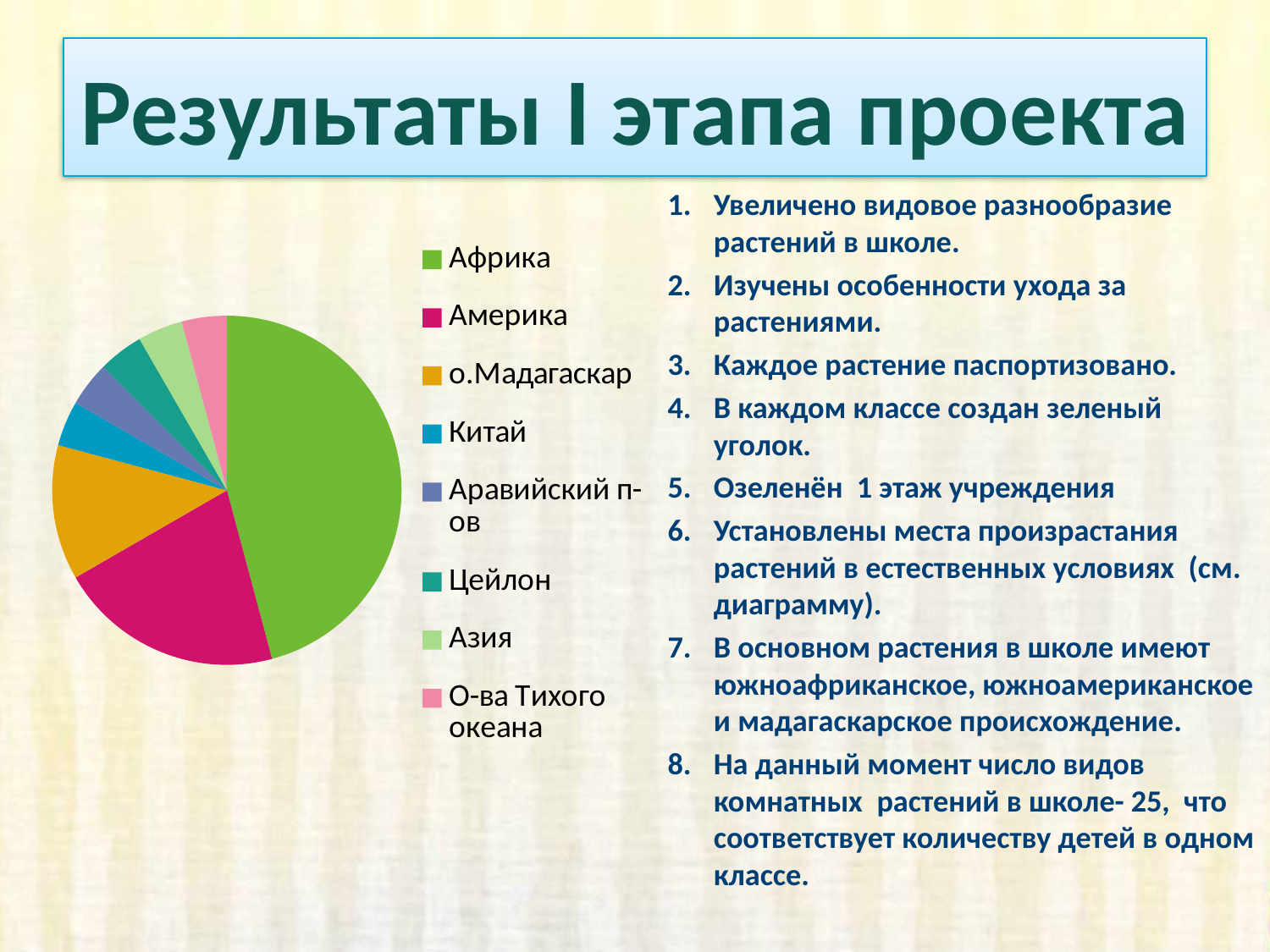
Which slice is larger in the pie chart, Америка or о.Мадагаскар? Америка How many categories does the pie chart show? 8 Which category has the second-largest slice in the pie chart? Америка Which slice is larger in the pie chart, Африка or Цейлон? Африка What colour is the Африка slice in the pie chart? green Which category is listed last in the pie chart's legend? О-ва Тихого океана Which slice is larger in the pie chart, о.Мадагаскар or Китай? о.Мадагаскар Which category has the largest slice in the pie chart? Африка What kind of chart is shown on the slide? pie chart